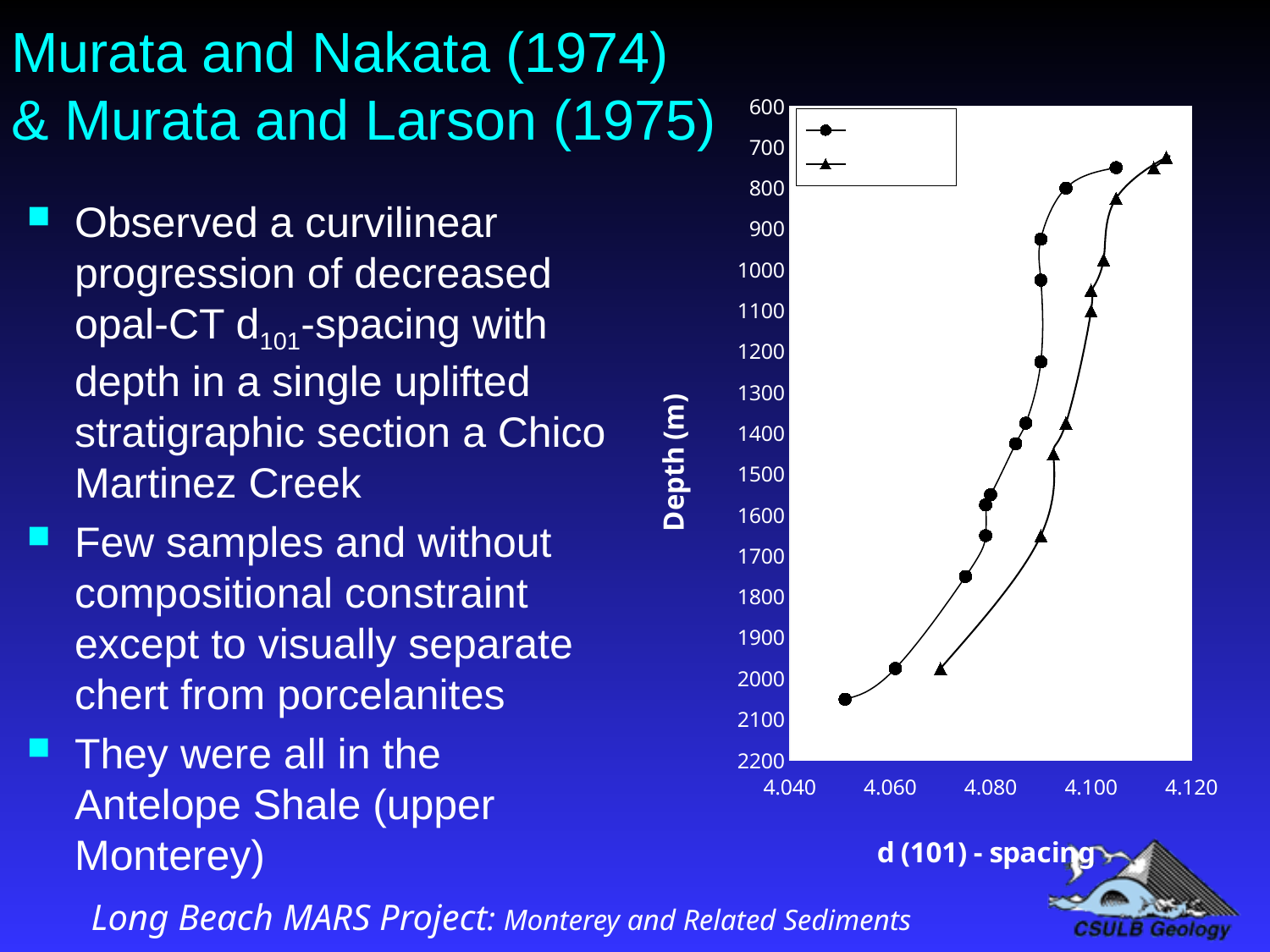
Is the d (101) - spacing of the deepest triangle-marker point (near 1950 m) greater or less than 4.060? greater At a depth of about 1000 m, which series has the larger d (101) - spacing, the circle-marker series or the triangle-marker series? the triangle-marker series As depth increases, does the d (101) - spacing of the circle-marker series increase or decrease? decrease Is the d (101) - spacing of the shallowest triangle-marker point (near 700 m) greater or less than 4.100? greater Is the d (101) - spacing of the deepest circle-marker point (near 2050 m) greater or less than 4.060? less What is the label of the horizontal axis of the chart? d (101) - spacing As depth increases, does the d (101) - spacing of the triangle-marker series increase or decrease? decrease At a depth of about 1650 m, which series has the smaller d (101) - spacing, the circle-marker series or the triangle-marker series? the circle-marker series What kind of chart is shown on the slide? Scatter chart with lines What is the label of the vertical axis of the chart? Depth (m) How many series does the chart's legend list? 2